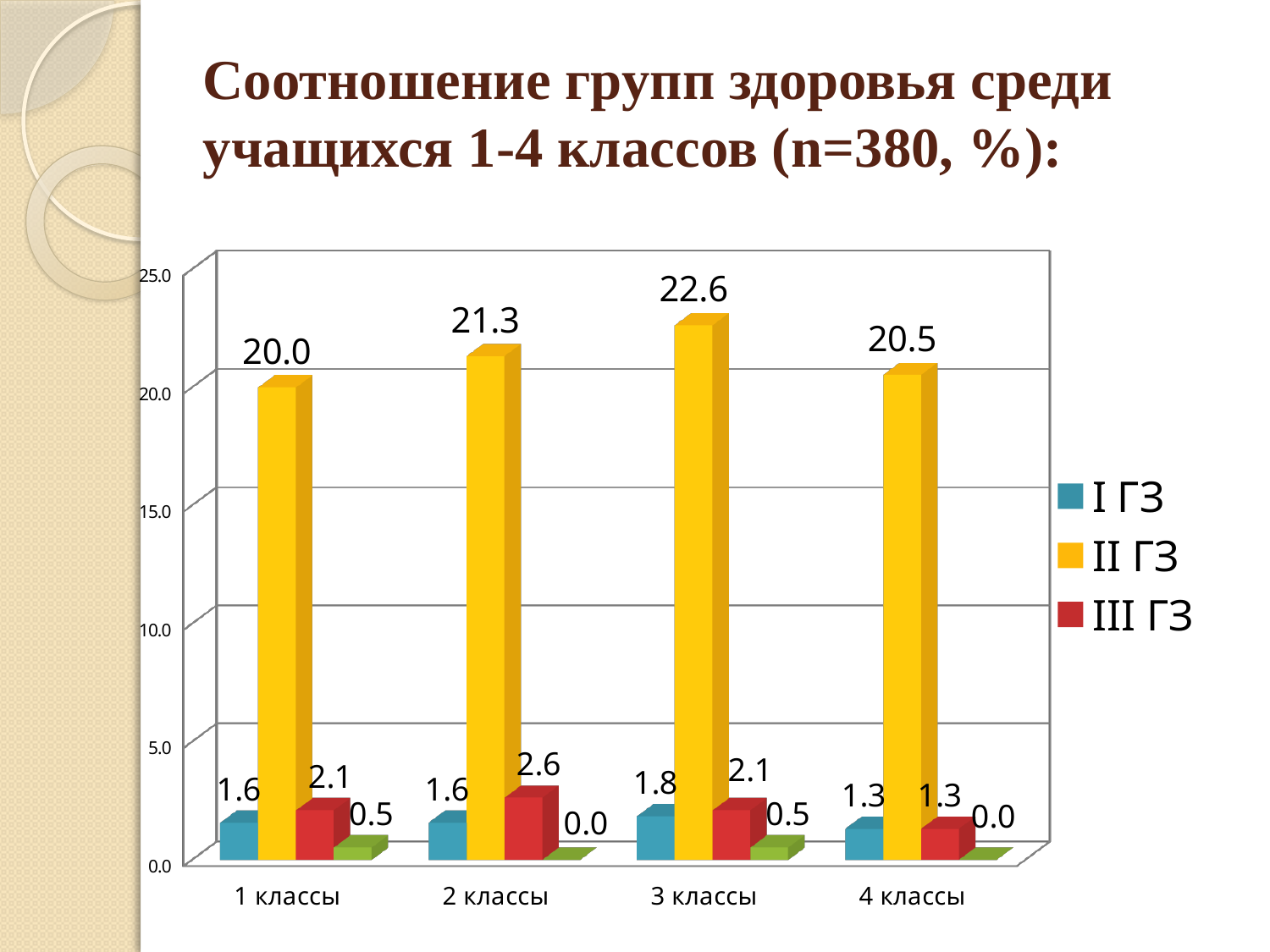
What is the value for II ГЗ in 3 классы? 22.6 How many series does the legend list? 3 Which is larger: the III ГЗ value for 2 классы or the III ГЗ value for 4 классы? 2 классы Which category has the lowest value for II ГЗ? 1 классы Is the value for II ГЗ in 2 классы greater or less than 20.0? greater What is the value for I ГЗ in 4 классы? 1.3 How many categories are shown on the x axis? 4 What is the value for II ГЗ in 1 классы? 20.0 What kind of chart is shown on the slide? bar chart What is the difference between the II ГЗ values for 3 классы and 1 классы? 2.6 Which category has the highest value for II ГЗ? 3 классы What is the value for III ГЗ in 2 классы? 2.6